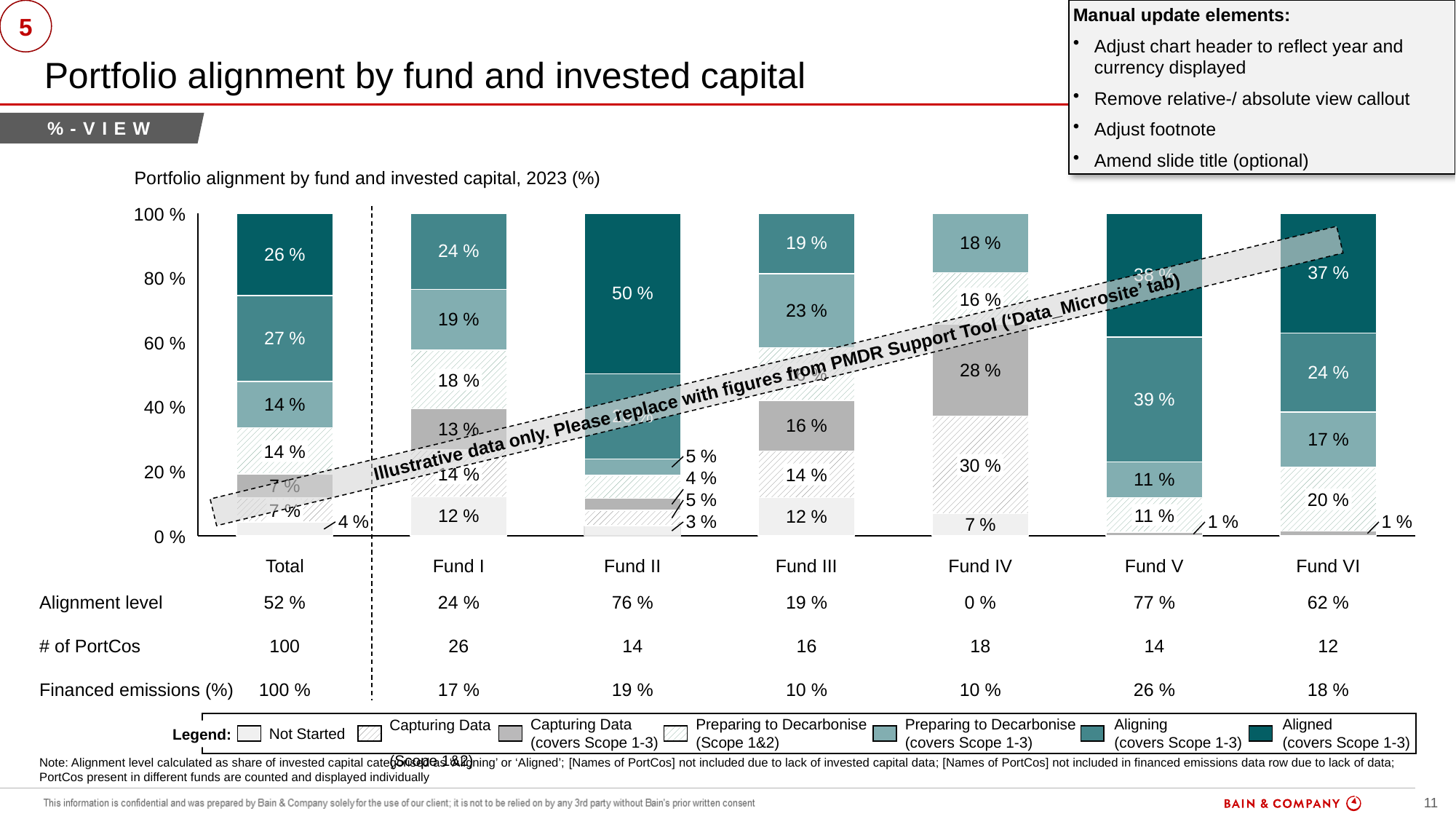
For Fund VI, what is the difference between the 'Aligned (covers Scope 1-3)' share and the 'Aligning (covers Scope 1-3)' share? 13 percentage points What is the 'Aligning (covers Scope 1-3)' share for Fund V? 39 % What is the 'Aligned (covers Scope 1-3)' share for Fund II? 50 % What is the 'Not Started' share for the Total bar? 4 % What is the title of the chart? Portfolio alignment by fund and invested capital, 2023 (%) What is the 'Capturing Data (covers Scope 1-3)' share for Fund IV? 28 % What is the 'Aligned (covers Scope 1-3)' share for the Total bar? 26 % How many categories (bars) are plotted along the x axis of the chart? 7 Which bar has the largest 'Aligned (covers Scope 1-3)' segment? Fund II How many series does the chart legend list? 7 What kind of chart is shown on the slide? Stacked bar chart